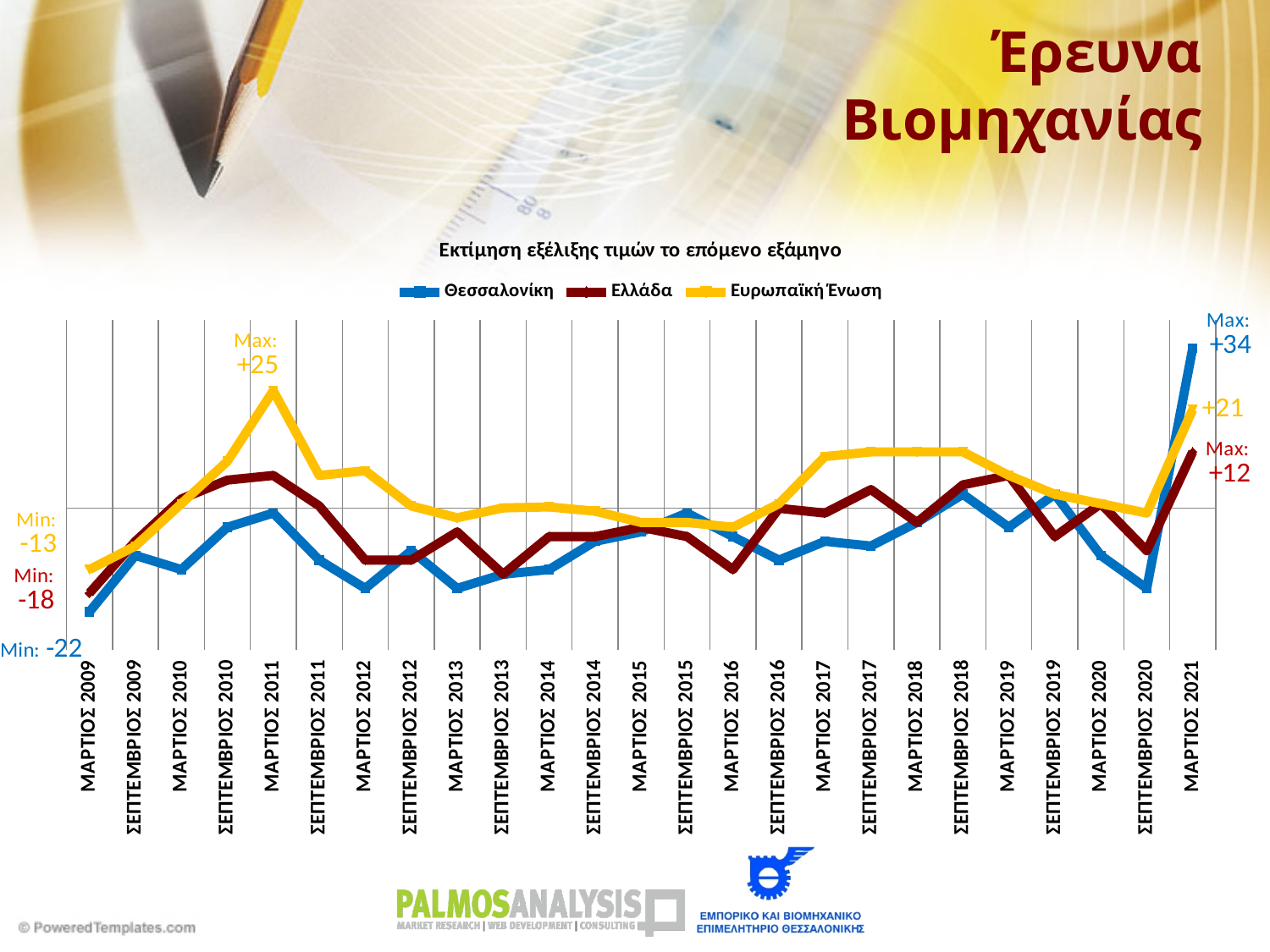
Which series has the highest value in ΜΑΡΤΙΟΣ 2021? Θεσσαλονίκη What is the title of the chart? Εκτίμηση εξέλιξης τιμών το επόμενο εξάμηνο What is the difference between the Θεσσαλονίκη and Ελλάδα values in ΜΑΡΤΙΟΣ 2021? 22 What is the maximum value reached by Ευρωπαϊκή Ένωση, labelled in ΜΑΡΤΙΟΣ 2011? +25 What is the value for Θεσσαλονίκη in ΜΑΡΤΙΟΣ 2021? +34 What kind of chart is shown on the slide? Line chart What is the minimum value for Ελλάδα, labelled in ΜΑΡΤΙΟΣ 2009? -18 Which series has the lowest value in ΜΑΡΤΙΟΣ 2009? Θεσσαλονίκη How many series does the legend list? 3 Is the Ευρωπαϊκή Ένωση value larger in ΜΑΡΤΙΟΣ 2011 or in ΜΑΡΤΙΟΣ 2021? ΜΑΡΤΙΟΣ 2011 How many time points are shown on the x axis? 25 What is the value for Ευρωπαϊκή Ένωση in ΜΑΡΤΙΟΣ 2021? +21